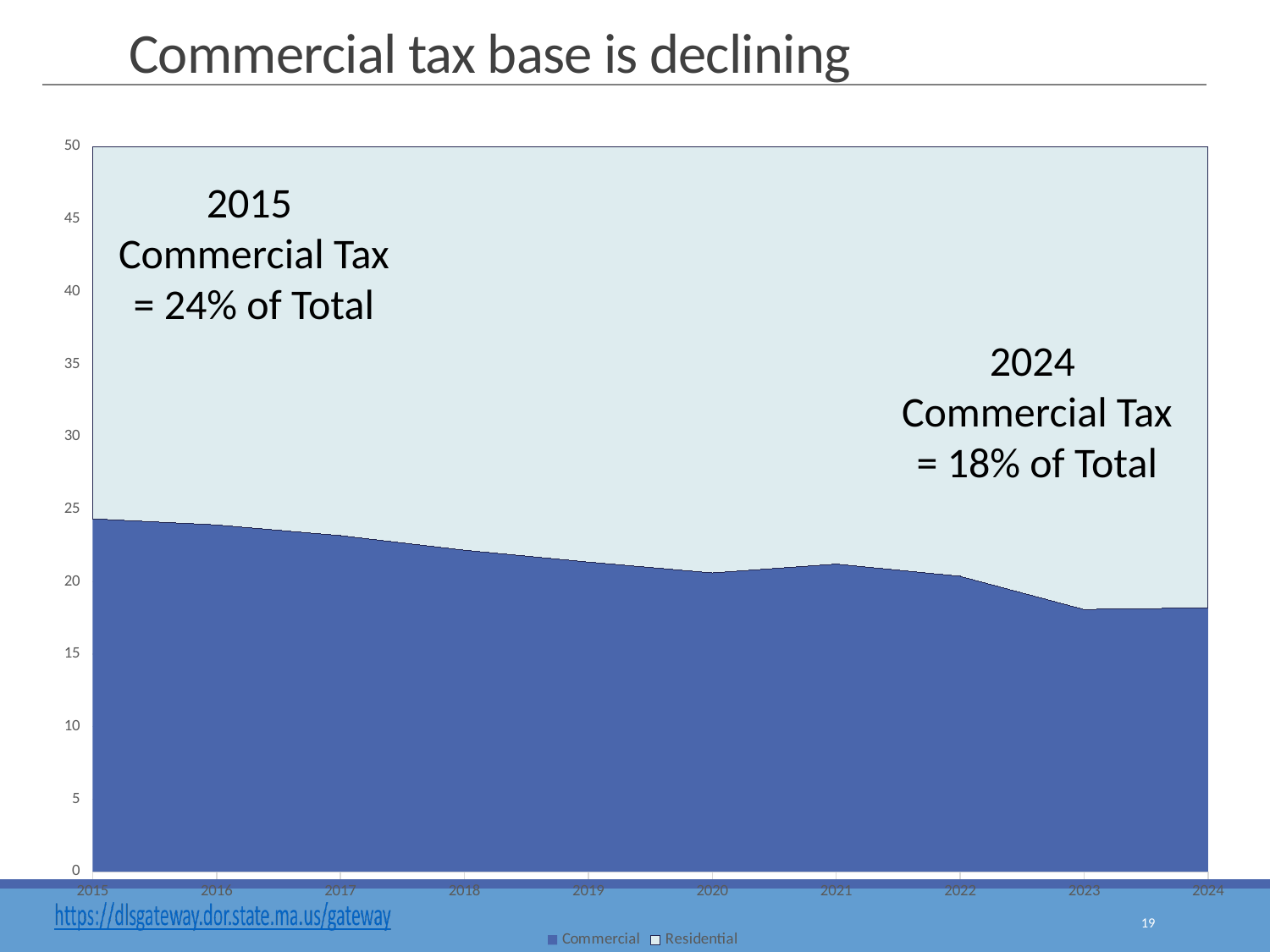
How many years are shown along the x axis? 10 Does the Commercial series generally rise or fall from 2015 to 2024? Fall Which two series are listed in the chart legend? Commercial and Residential By how many percentage points did the Commercial Tax share of the total fall between 2015 and 2024, according to the annotations? 6 percentage points According to the annotation, what share of the total was Commercial Tax in 2015? 24% of Total How many series does the legend list? 2 What kind of chart is shown on the slide? Area chart What is the title of the slide? Commercial tax base is declining Is the Commercial value for 2015 greater or less than 20? greater Is the Commercial value for 2024 greater or less than 20? less According to the annotation, what share of the total was Commercial Tax in 2024? 18% of Total Which year has the highest Commercial value? 2015